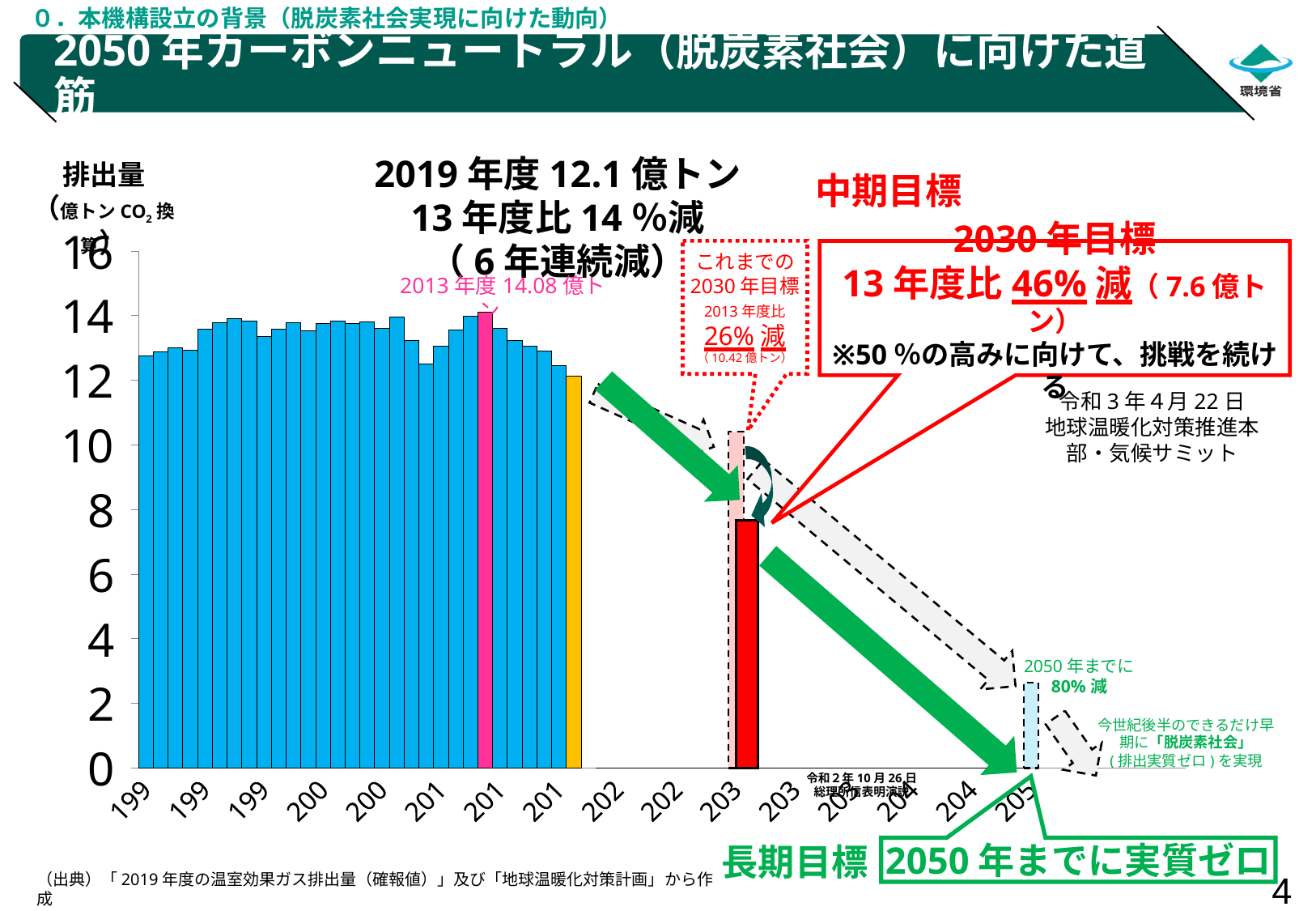
What is the label of the vertical axis? 排出量（億トン CO2換算） Is the value of the 2030 target bar greater or less than 10? less What emissions level does the 2030 target (red bar) correspond to? 7.6億トン Which is larger, the emissions value for 2013 or for 2019? 2013 What was the emissions value for fiscal year 2013 (the pink bar)? 14.08億トン What was the emissions value for fiscal year 2019 (the orange bar)? 12.1億トン What is the difference between the 2013 emissions value and the 2019 emissions value? 1.98億トン By what percentage is the 2030 target reduced compared with fiscal year 2013? 46% What kind of chart is shown on the slide? bar chart What colour is the bar for fiscal year 2013? pink Do the emissions bars rise or fall from 2013 to 2019? fall What emissions level did the previous 2030 target (26% reduction) correspond to? 10.42億トン